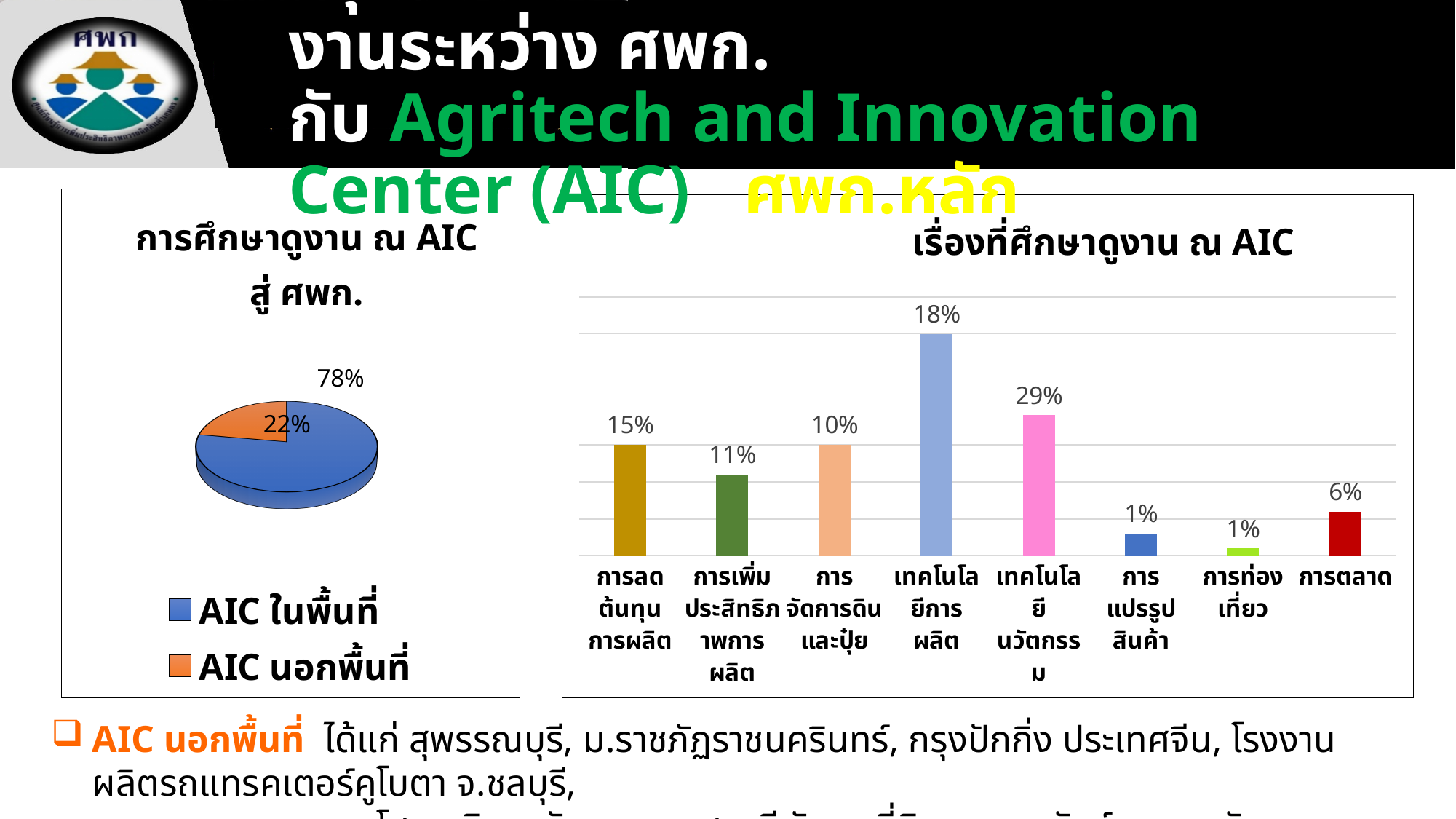
In the bar chart titled เรื่องที่ศึกษาดูงาน ณ AIC, what is the value for การตลาด? 6% In the bar chart titled เรื่องที่ศึกษาดูงาน ณ AIC, how many categories are shown on the x axis? 8 In the pie chart titled การศึกษาดูงาน ณ AIC สู่ ศพก., by how many percentage points does AIC ในพื้นที่ exceed AIC นอกพื้นที่? 56 percentage points In the bar chart titled เรื่องที่ศึกษาดูงาน ณ AIC, what is the value for การลดต้นทุนการผลิต? 15% In the bar chart titled เรื่องที่ศึกษาดูงาน ณ AIC, which is larger: การลดต้นทุนการผลิต or การตลาด? การลดต้นทุนการผลิต In the bar chart titled เรื่องที่ศึกษาดูงาน ณ AIC, what is the value for การจัดการดินและปุ๋ย? 10% In the pie chart titled การศึกษาดูงาน ณ AIC สู่ ศพก., what share is labelled for AIC ในพื้นที่? 78% In the pie chart titled การศึกษาดูงาน ณ AIC สู่ ศพก., which category has the largest slice? AIC ในพื้นที่ In the pie chart titled การศึกษาดูงาน ณ AIC สู่ ศพก., how many entries does the legend list? 2 In the pie chart titled การศึกษาดูงาน ณ AIC สู่ ศพก., what share is labelled for AIC นอกพื้นที่? 22% In the bar chart titled เรื่องที่ศึกษาดูงาน ณ AIC, what is the difference between การลดต้นทุนการผลิต and การจัดการดินและปุ๋ย? 5 percentage points What kind of chart is the one on the left titled การศึกษาดูงาน ณ AIC สู่ ศพก.? Pie chart